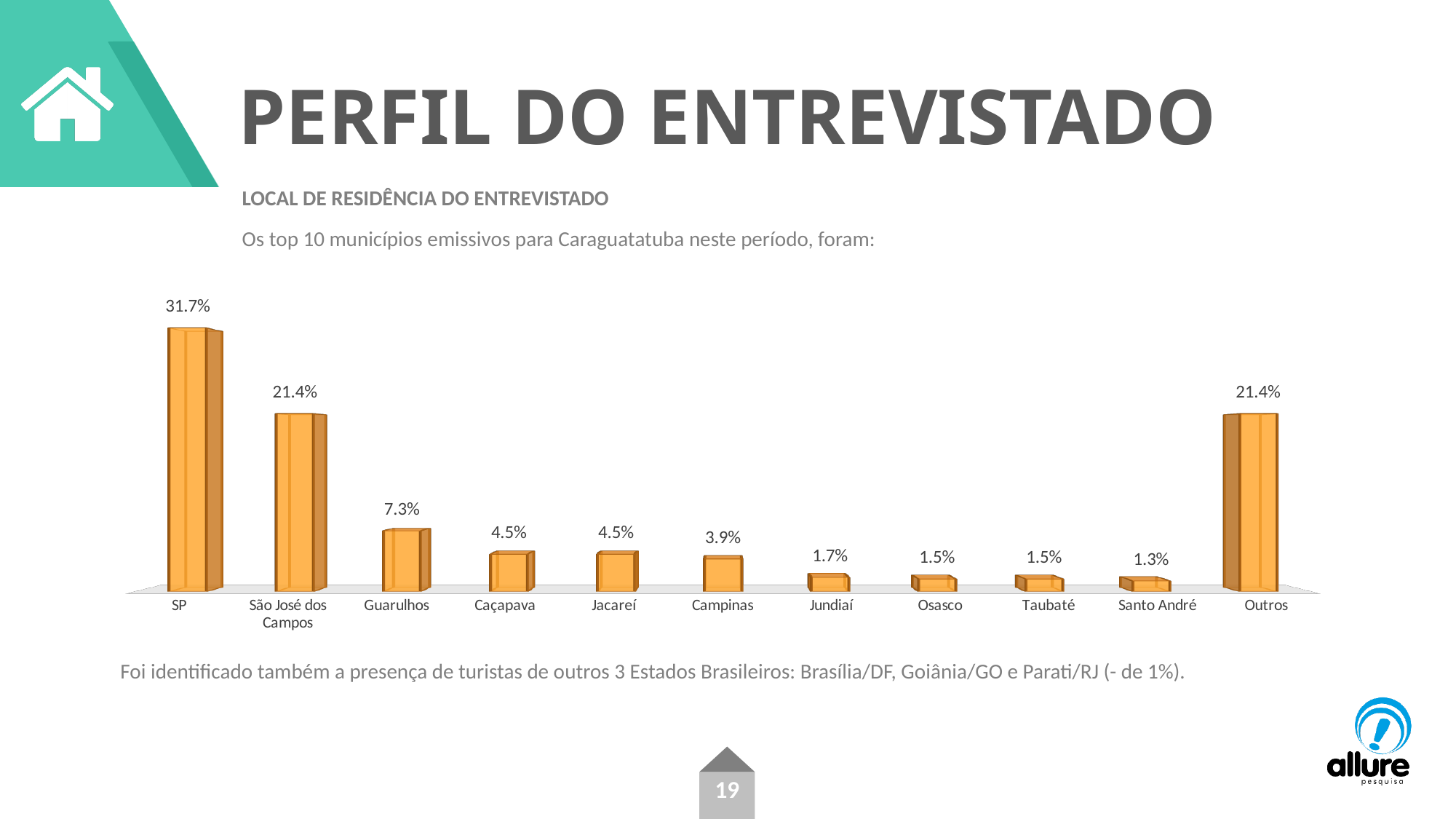
What is the value for Guarulhos? 7.3% How many categories are shown on the x axis? 11 What is the value for Outros? 21.4% Which is larger, the value for Guarulhos or the value for Campinas? Guarulhos What is the difference between the values for SP and São José dos Campos? 10.3% Which category has the lowest value? Santo André What kind of chart is shown on the slide? Bar chart Which category has the highest value? SP What is the value for Campinas? 3.9% What is the value for SP? 31.7% What is the difference between the values for Guarulhos and Jundiaí? 5.6% What colour are the bars in the chart? Orange